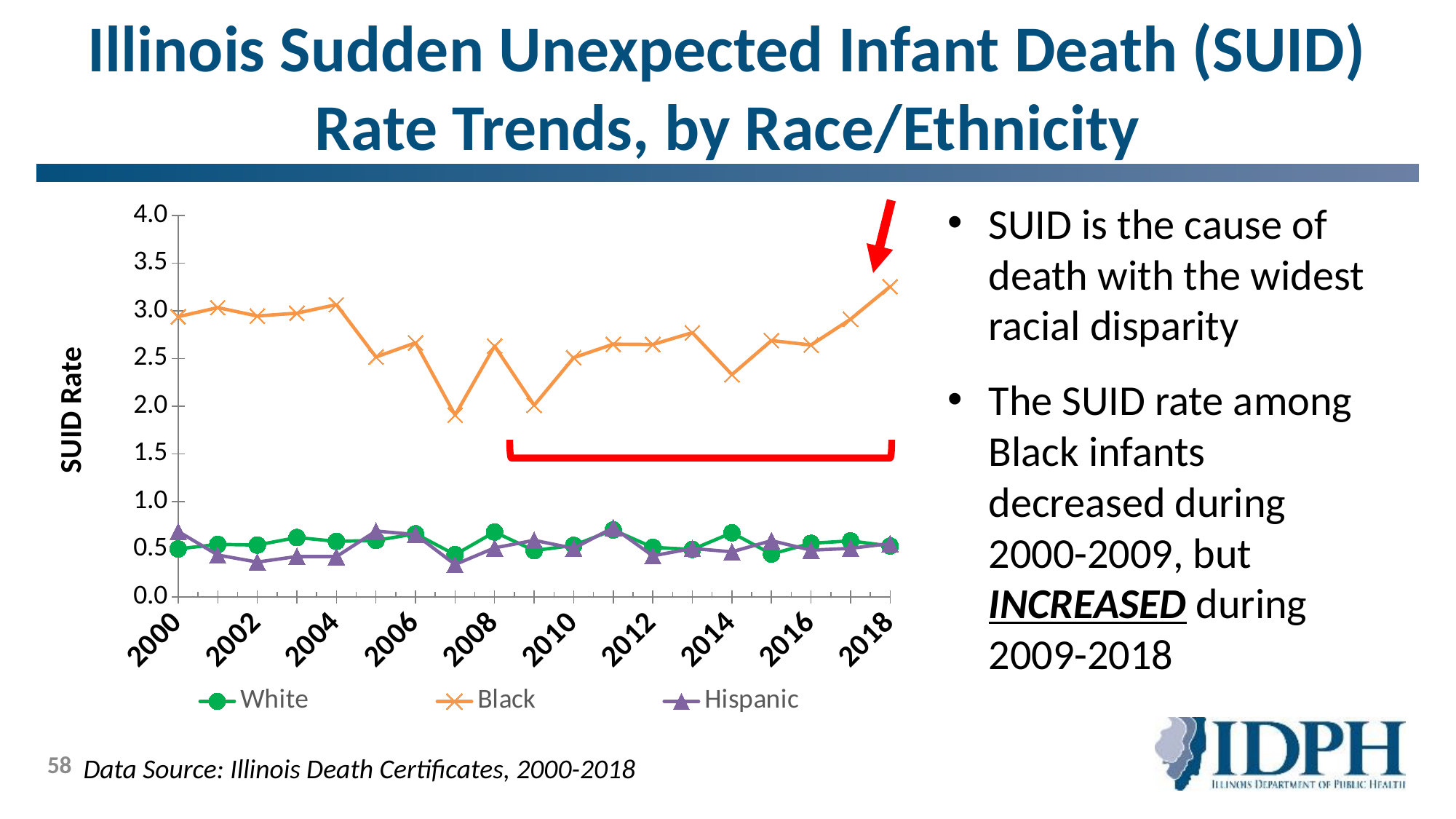
Is the SUID rate for Black infants in 2014 greater or less than 2.5? less Is the SUID rate for Black infants in 2018 greater or less than 3.0? greater Which race/ethnicity series has the highest SUID rate across the chart? Black Which is larger in 2018, the SUID rate for Black infants or for White infants? Black What is the label on the y axis? SUID Rate Does the SUID rate for Black infants rise or fall from 2014 to 2018? rise How many series does the legend list? 3 Which series does the legend list between White and Hispanic? Black What kind of chart is shown on the slide? line chart Does the SUID rate for Black infants rise or fall from 2004 to 2007? fall Is the SUID rate for Hispanic infants in 2007 greater or less than 0.5? less In which year does the Black series reach its highest SUID rate? 2018